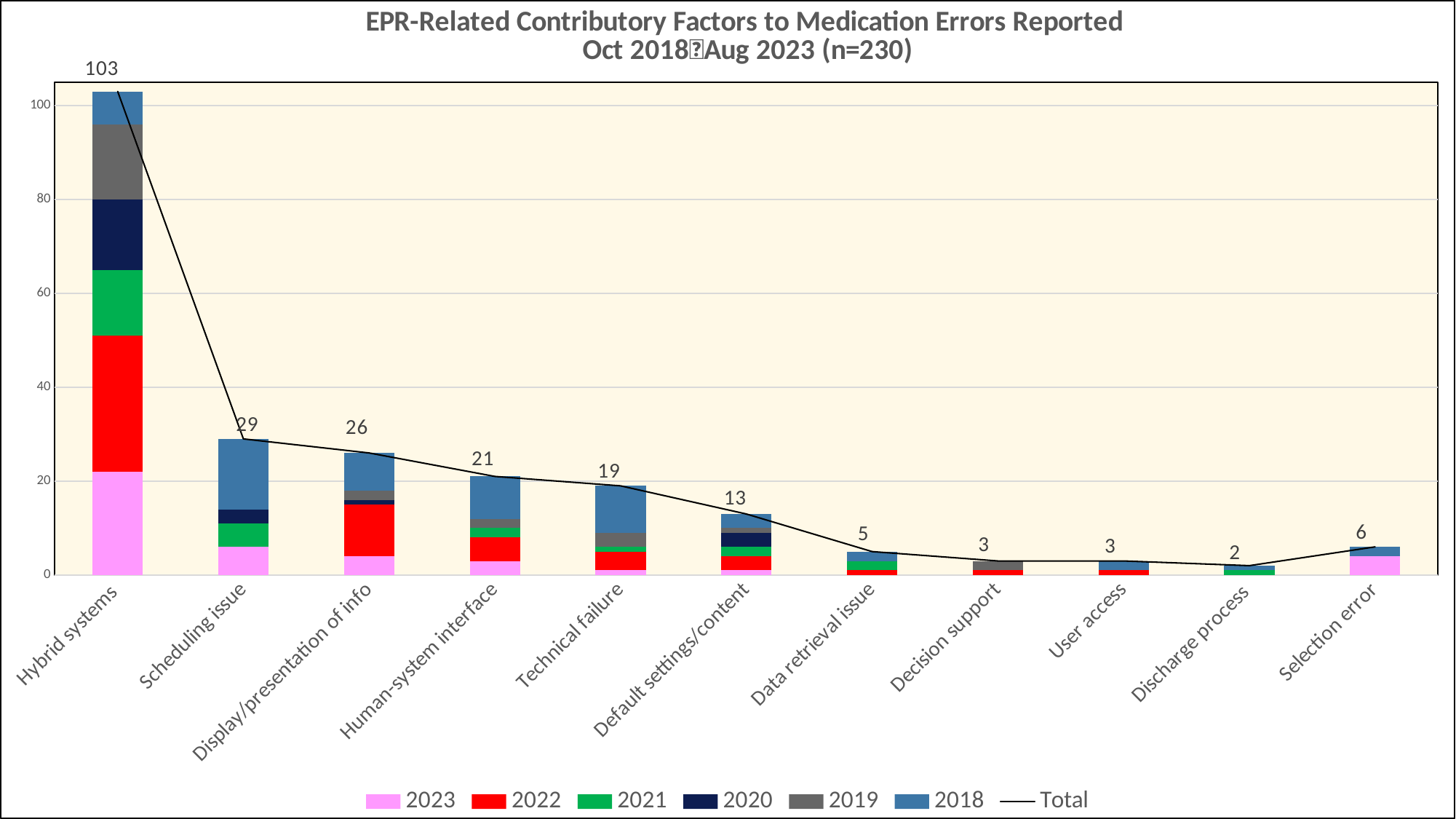
What is the total value shown for Hybrid systems? 103 How many categories are shown on the x axis? 11 What kind of chart is this? Stacked bar chart with a line Which colour represents 2022 in the legend? Red What is the total value shown for Scheduling issue? 29 Is the total for Hybrid systems greater or less than 100? greater What is the total value shown for Default settings/content? 13 Which category has the lowest total? Discharge process How many entries does the legend list? 7 Which category has the highest total? Hybrid systems What is the difference between the totals for Scheduling issue and Display/presentation of info? 3 Which has a larger total, Technical failure or Human-system interface? Human-system interface